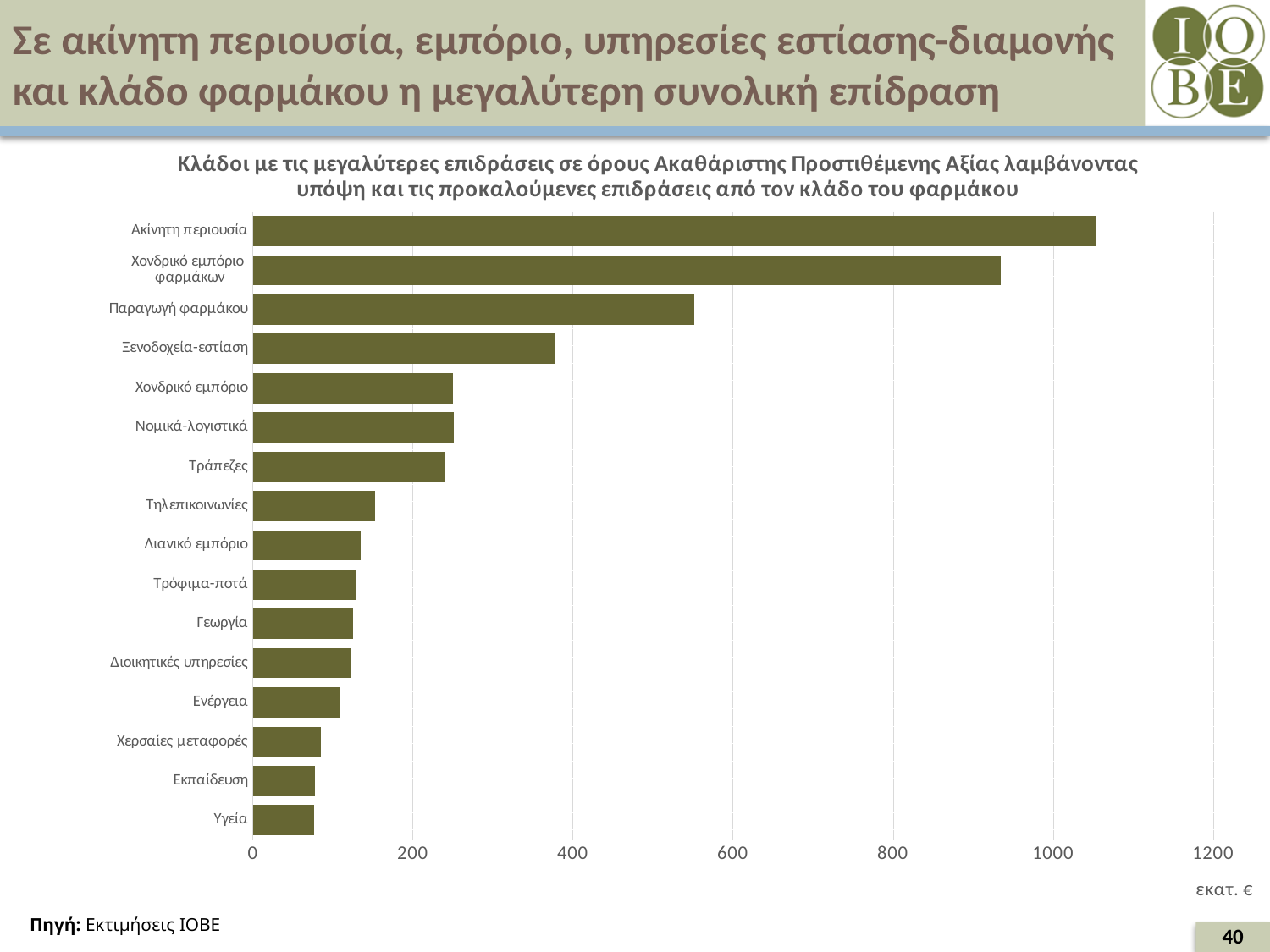
Is the value for Χονδρικό εμπόριο φαρμάκων greater or less than 1000? less Is the value for Τηλεπικοινωνίες greater or less than 200? less Which sector has the highest value in the chart? Ακίνητη περιουσία Which is larger, the value for Παραγωγή φαρμάκου or the value for Ξενοδοχεία-εστίαση? Παραγωγή φαρμάκου How many sectors (categories) are plotted in the chart? 16 Is the value for Ξενοδοχεία-εστίαση greater or less than 400? less What kind of chart is shown on the slide? Bar chart Which is larger, the value for Τράπεζες or the value for Τηλεπικοινωνίες? Τράπεζες What unit is shown at the bottom right of the chart's axis? εκατ. €